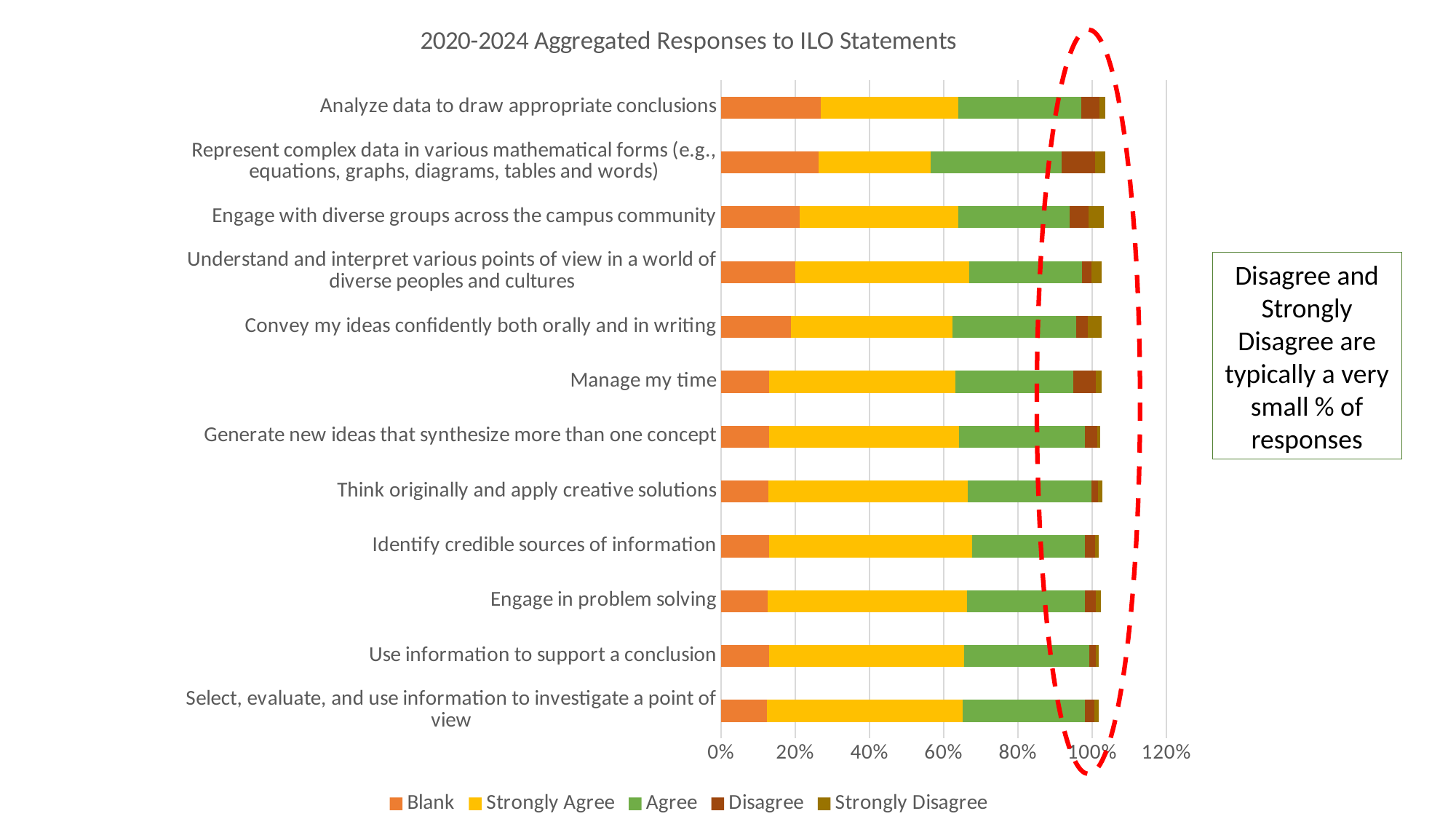
Which has a larger Blank value: "Represent complex data in various mathematical forms" or "Identify credible sources of information"? Represent complex data in various mathematical forms What kind of chart is shown on the slide? Stacked bar chart Which has a larger Blank value: "Analyze data to draw appropriate conclusions" or "Manage my time"? Analyze data to draw appropriate conclusions Is the Blank value for "Analyze data to draw appropriate conclusions" greater or less than 20%? greater What is the highest value shown on the x axis? 120% Is the Blank value for "Engage in problem solving" greater or less than 20%? less Which series is shown in orange in the legend? Blank How many ILO statements (categories) are plotted on the chart? 12 What is the title of the chart? 2020-2024 Aggregated Responses to ILO Statements How many series does the legend list? 5 Is the Blank value for "Manage my time" greater or less than 20%? less